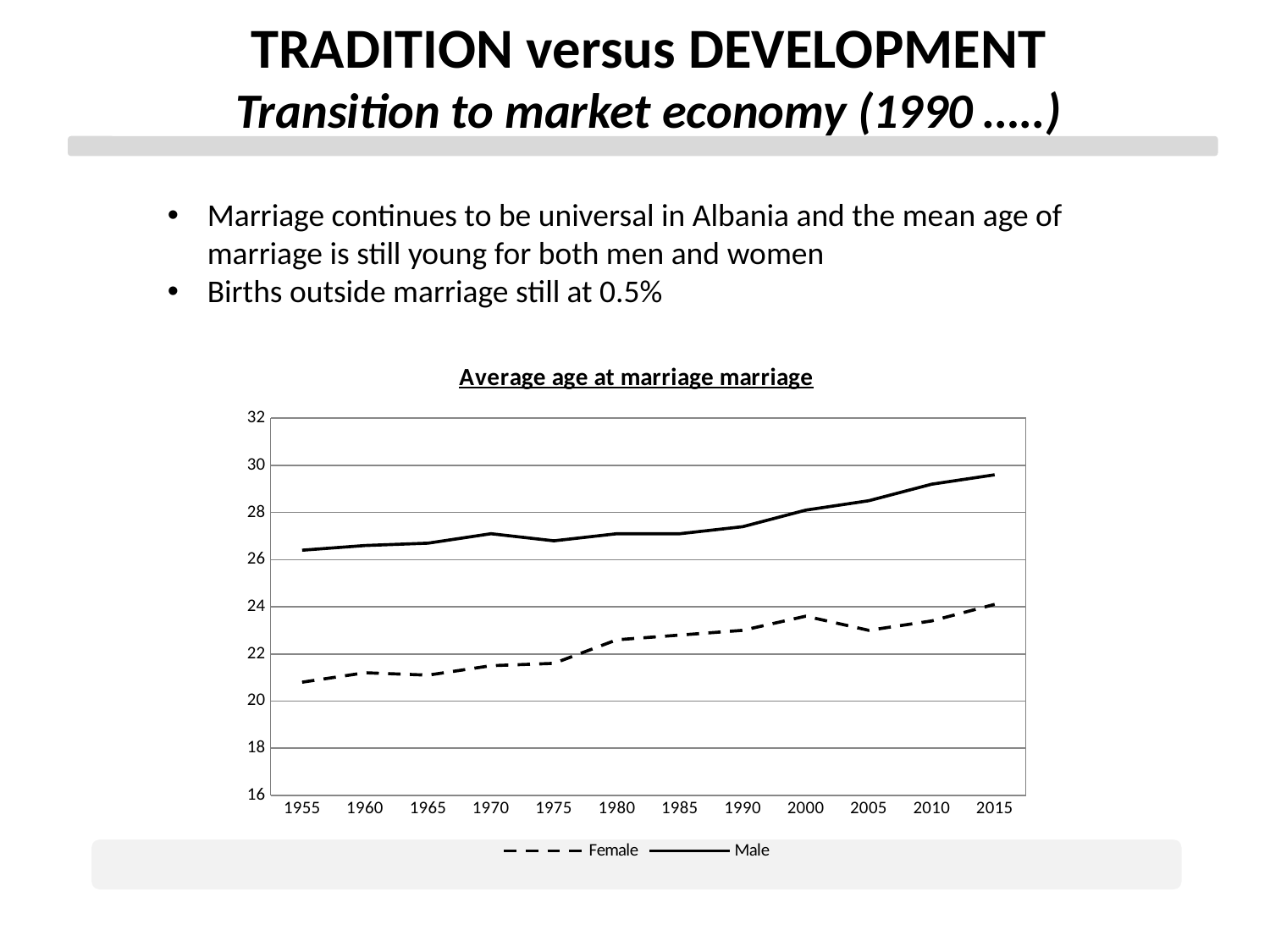
How many series does the chart's legend list? 2 Which series is drawn with a dashed line? Female What is the title of the chart? Average age at marriage marriage How many years are plotted along the x axis? 12 Is the Male value for 1955 greater or less than 28? less What kind of chart is shown on the slide? line chart Is the Male value for 2015 greater or less than 28? greater Is the Female value for 1955 greater or less than 22? less Does the Male series generally rise or fall from 1955 to 2015? rise In which year does the Male series reach its highest value? 2015 In 2015, which series has the higher value, Female or Male? Male